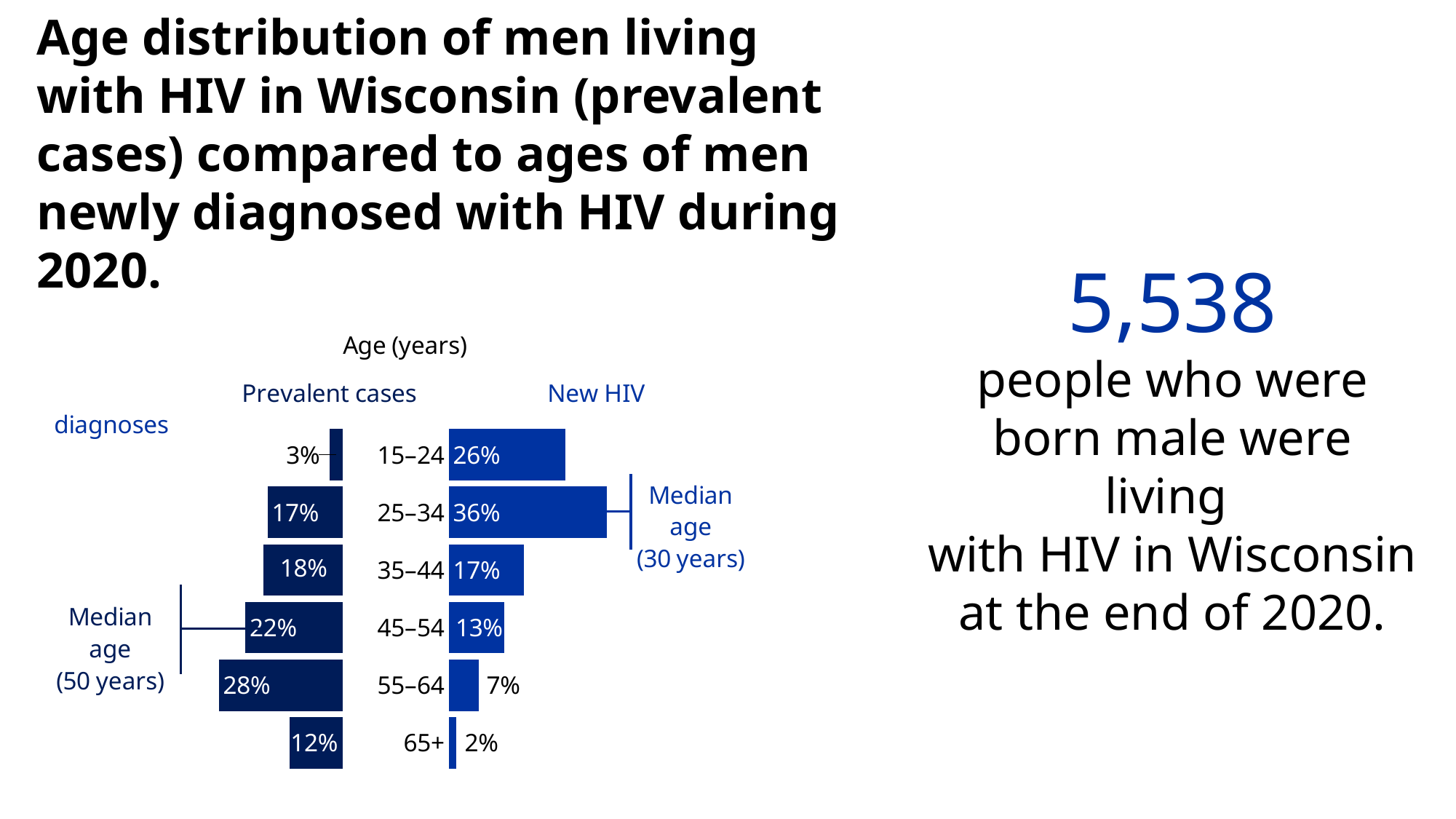
What percentage of prevalent cases are in the 55–64 age group? 28% What kind of chart is shown on the slide? Bar chart How many series does the chart show? 2 Which age group has the lowest share of prevalent cases? 15–24 For the 45–54 age group, which is larger: the prevalent cases share or the new HIV diagnoses share? Prevalent cases Which age group has the highest share of new HIV diagnoses? 25–34 How many age groups are shown in the chart? 6 What percentage of new HIV diagnoses are in the 25–34 age group? 36% What percentage of prevalent cases are in the 15–24 age group? 3% What is the median age of men newly diagnosed with HIV, as annotated on the chart? 30 years Which age group has the lowest share of new HIV diagnoses? 65+ What is the difference between the new HIV diagnoses share and the prevalent cases share for the 15–24 age group? 23 percentage points